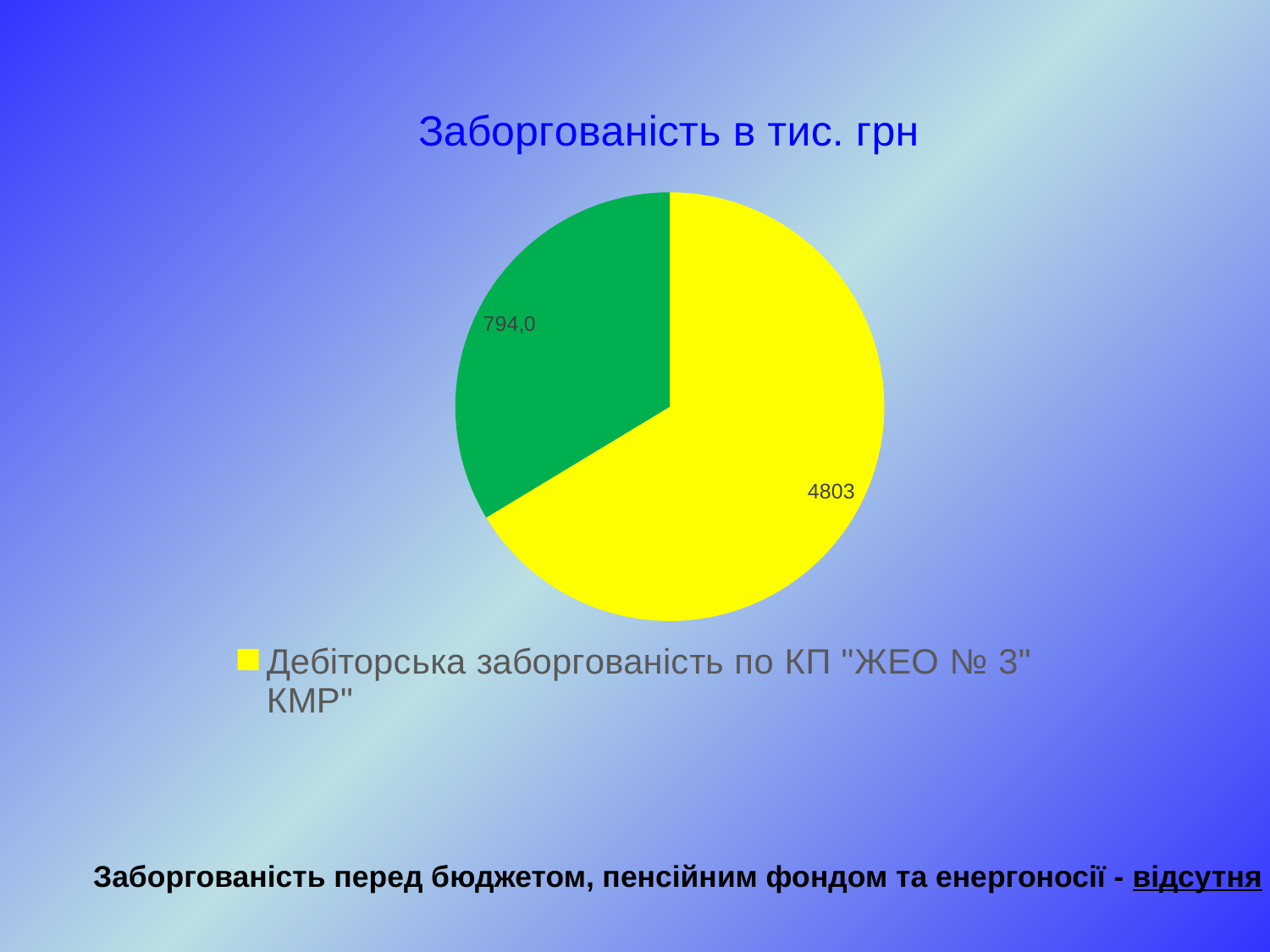
How many entries does the legend list? 1 What value is printed on the yellow slice of the pie chart? 4803 Which is larger, the yellow slice or the green slice? the yellow slice How many slices does the pie chart have? 2 What colour is the slice for "Дебіторська заборгованість по КП "ЖЕО № 3" КМР" in the legend? yellow What value is shown for the slice labelled "Дебіторська заборгованість по КП "ЖЕО № 3" КМР"? 4803 Which slice of the pie chart is the smallest? the green slice (794,0) What value is printed on the green slice of the pie chart? 794,0 What is the difference between the yellow slice value and the green slice value? 4009 What kind of chart is shown on the slide? pie chart What is the title of the chart? Заборгованість в тис. грн Which slice of the pie chart is the largest? the yellow slice (4803)